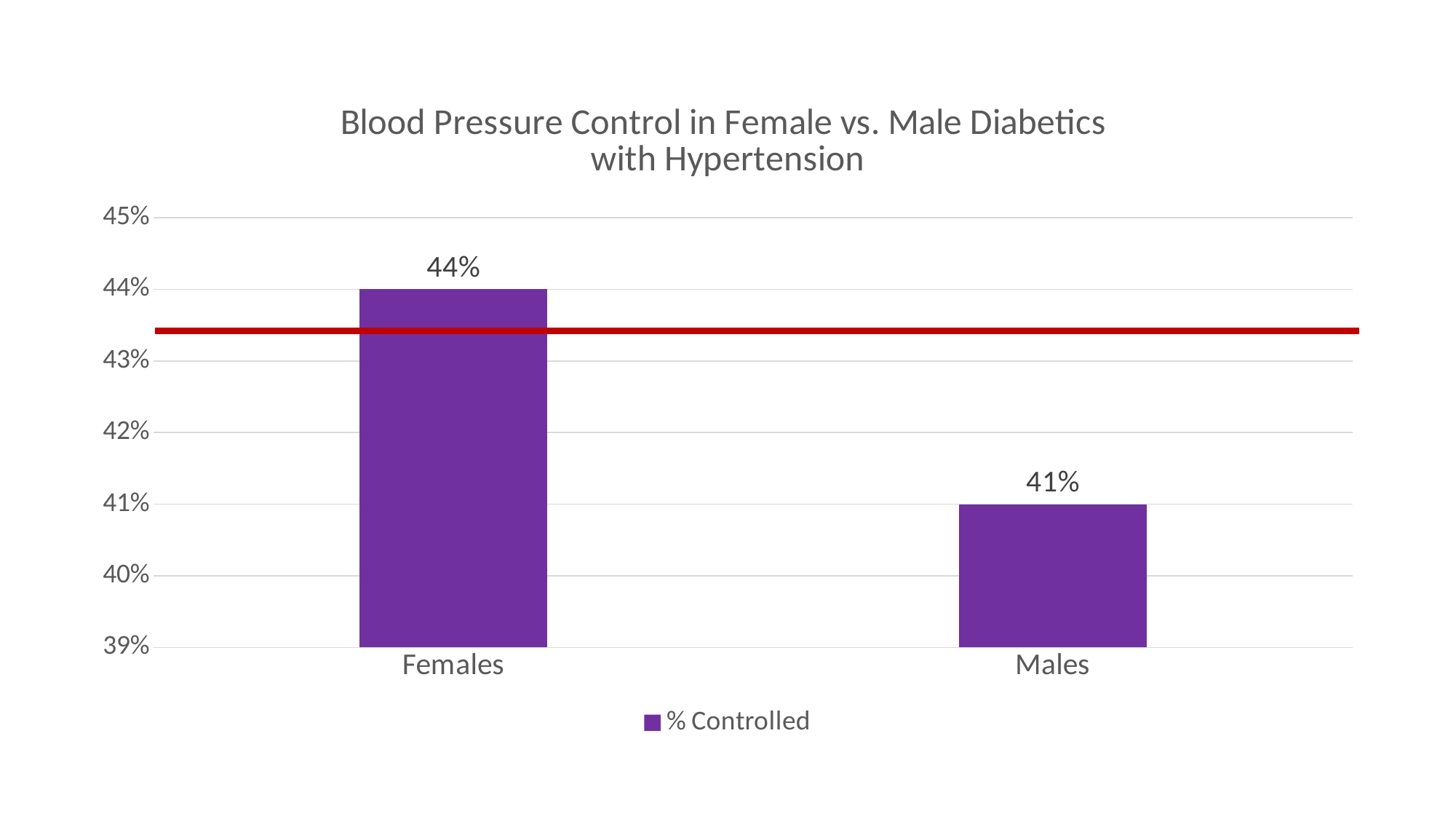
Is the value for Males greater or less than 42%? less What is the title of the chart? Blood Pressure Control in Female vs. Male Diabetics with Hypertension Which category has the highest % Controlled value? Females What is the difference between the % Controlled values for Females and Males? 3% What kind of chart is shown on the slide? Bar chart What is the % Controlled value for Females? 44% Which has a larger % Controlled value, Females or Males? Females Is the value for Females greater or less than 43%? greater Which category has the lowest % Controlled value? Males What is the % Controlled value for Males? 41% How many series does the legend list? 1 How many categories are shown on the x axis? 2